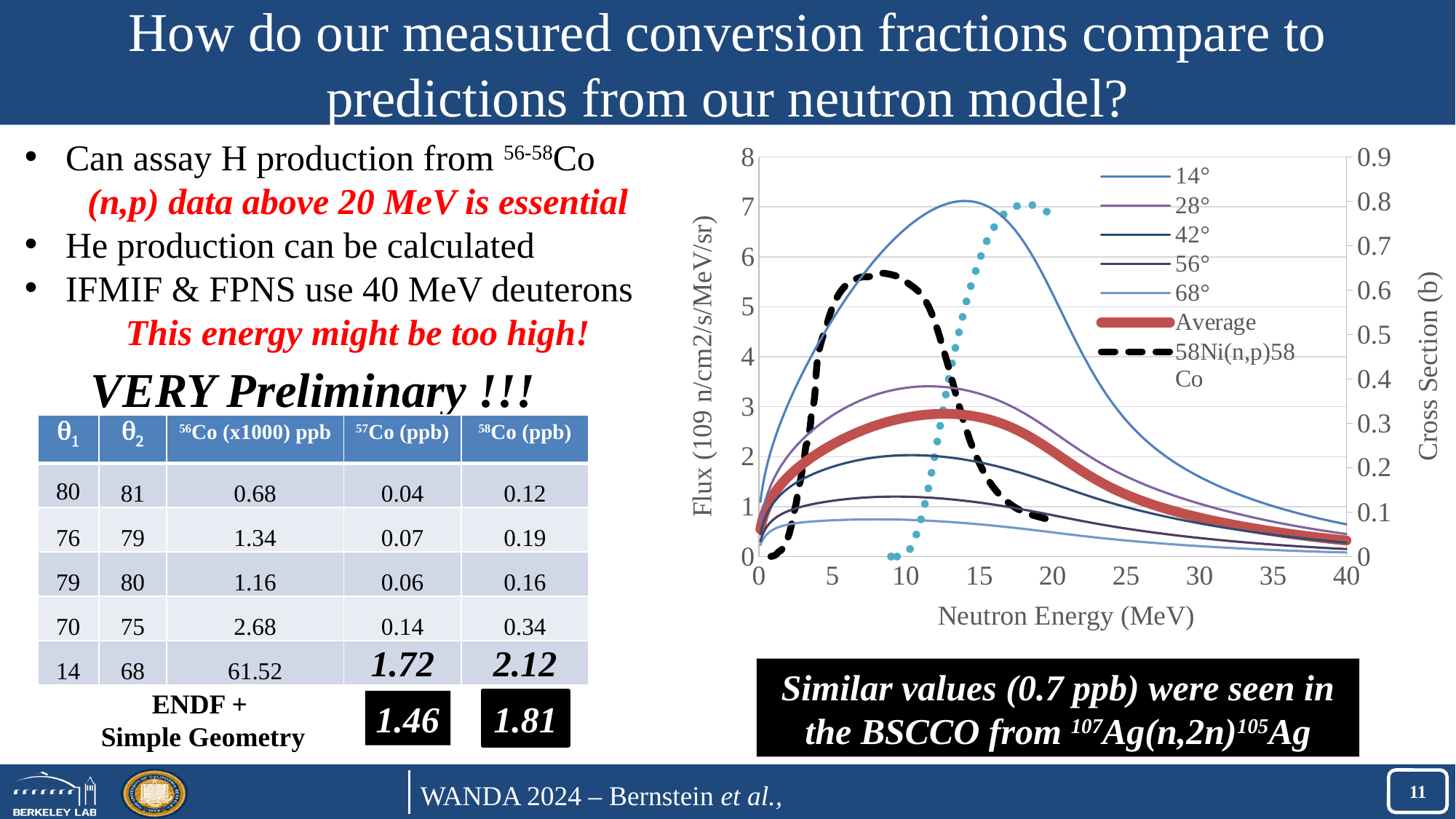
Is the peak flux of the 68° series greater or less than 1? less What is the label of the right-hand y axis of the chart? Cross Section (b) Does the flux of the 14° series rise or fall as neutron energy increases from 15 MeV to 40 MeV? fall At 10 MeV, which series has the larger flux, 14° or 28°? 14° Which angle series reaches the highest peak flux in the chart? 14° How many series does the chart's legend list? 7 Is the peak flux of the 28° series greater or less than 3? greater What is the label of the x axis of the chart? Neutron Energy (MeV) What kind of chart is shown on the slide? line chart Which angle series has the lowest flux across the chart? 68° Is the peak flux of the 14° series greater or less than 6? greater